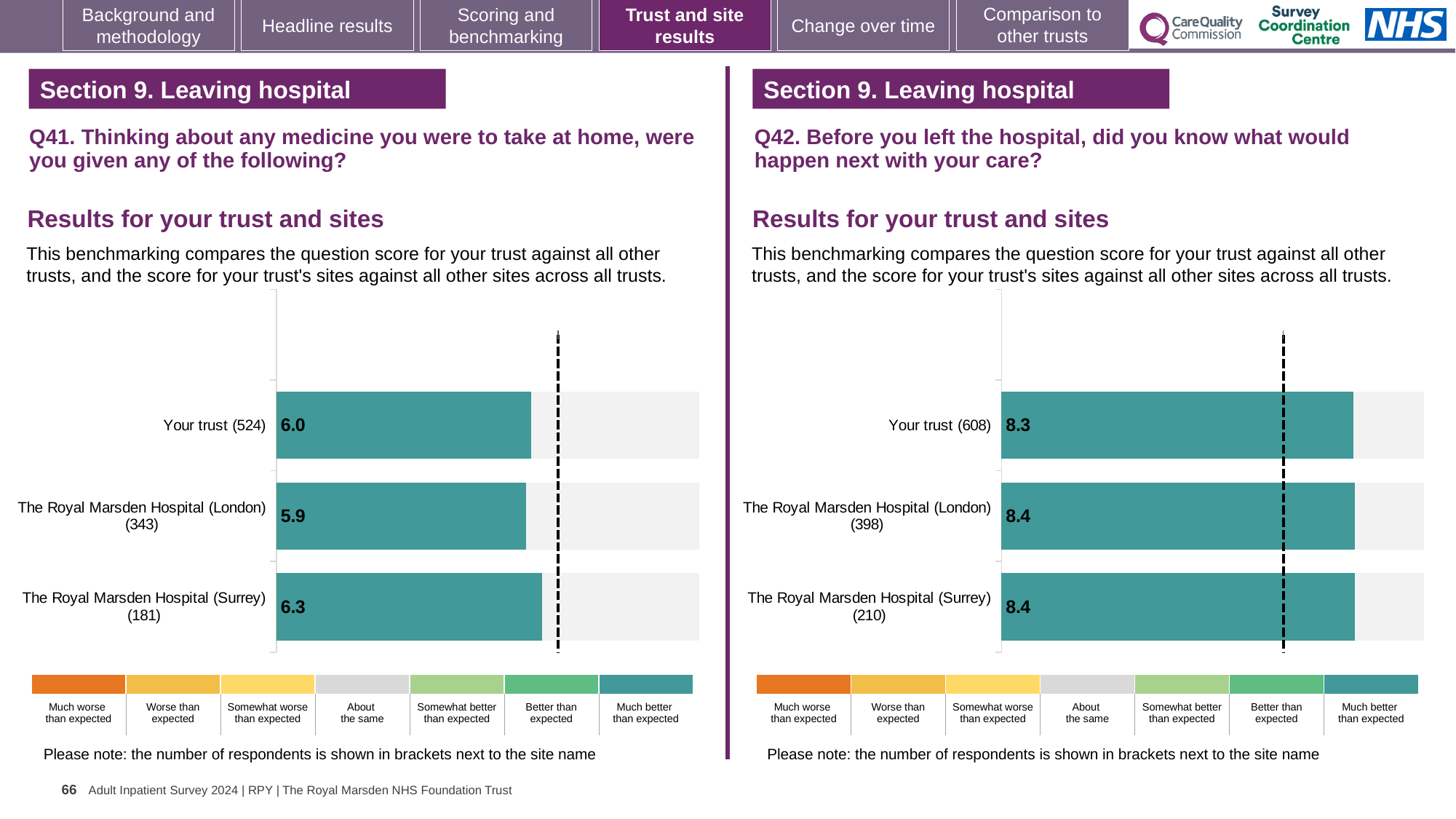
On the Q41 chart (left), what is the score for The Royal Marsden Hospital (Surrey) (181)? 6.3 On the Q42 chart (right), how many bars are plotted? 3 On the Q42 chart (right), what is the difference between the scores for The Royal Marsden Hospital (Surrey) and Your trust? 0.1 On the Q42 chart (right), how many respondents are shown in brackets for The Royal Marsden Hospital (Surrey)? 210 On the Q41 chart (left), which category has the lowest score? The Royal Marsden Hospital (London) (343) On the Q41 chart (left), what is the score for Your trust (524)? 6.0 On the Q41 chart (left), what is the difference between the scores for The Royal Marsden Hospital (Surrey) and The Royal Marsden Hospital (London)? 0.4 On the Q42 chart (right), what is the score for The Royal Marsden Hospital (London) (398)? 8.4 What type of chart is used on the Q41 chart (left)? Bar chart On the Q42 chart (right), what is the score for Your trust (608)? 8.3 On the Q41 chart (left), is the score for Your trust larger or smaller than the score for The Royal Marsden Hospital (Surrey)? Smaller On the Q41 chart (left), which category has the highest score? The Royal Marsden Hospital (Surrey) (181)